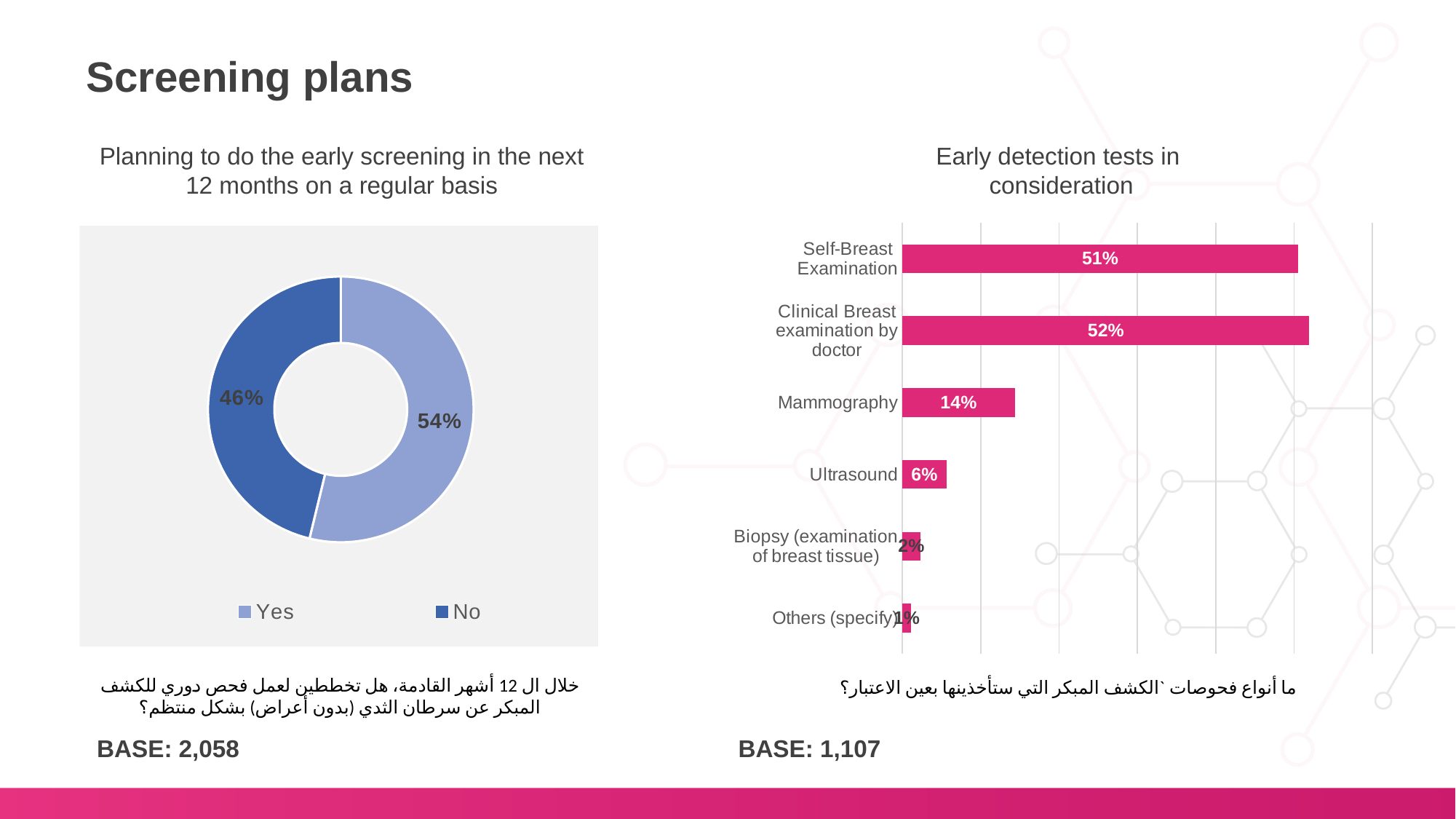
In the 'Planning to do the early screening in the next 12 months on a regular basis' chart, what share of respondents answered Yes? 54% In the 'Early detection tests in consideration' chart, what is the value for Mammography? 14% In the 'Early detection tests in consideration' chart, which test has the highest value? Clinical Breast examination by doctor In the 'Early detection tests in consideration' chart, what is the value for Ultrasound? 6% How many entries does the legend of the 'Planning to do the early screening in the next 12 months on a regular basis' chart list? 2 What kind of chart is the 'Early detection tests in consideration' chart? Bar chart In the 'Early detection tests in consideration' chart, what is the difference between Mammography and Ultrasound? 8% In the 'Planning to do the early screening in the next 12 months on a regular basis' chart, what is the difference between the Yes and No shares? 8% What kind of chart is the 'Planning to do the early screening in the next 12 months on a regular basis' chart? Doughnut chart In the 'Early detection tests in consideration' chart, how many tests are listed? 6 In the 'Early detection tests in consideration' chart, which test has the lowest value? Others (specify) In the 'Planning to do the early screening in the next 12 months on a regular basis' chart, what share of respondents answered No? 46%